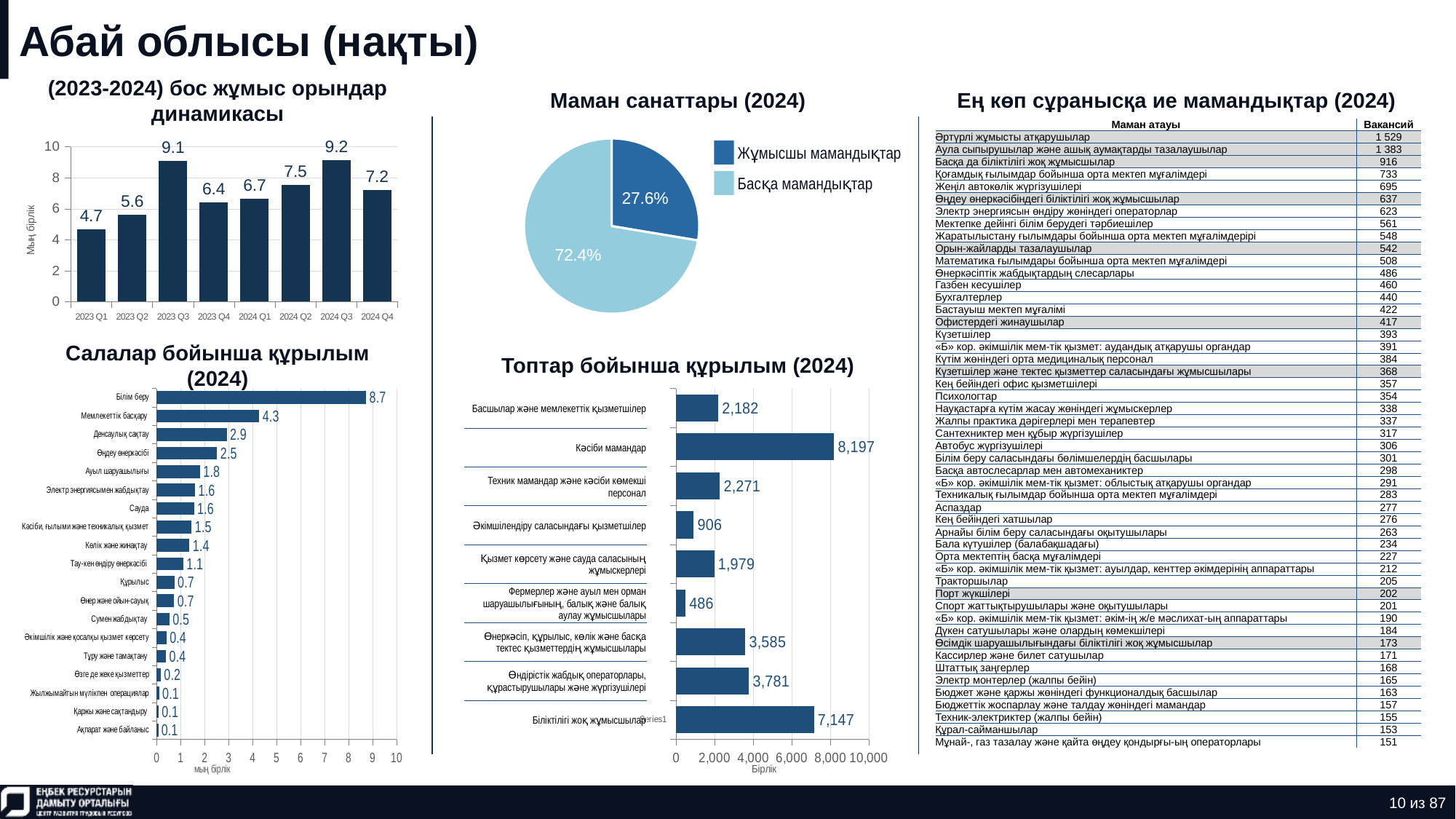
In the chart 'Топтар бойынша құрылым (2024)', which is larger: 'Өндірістік жабдық операторлары, құрастырушылары және жүргізушілері' or 'Өнеркәсіп, құрылыс, көлік және басқа тектес қызметтердің жұмысшылары'? Өндірістік жабдық операторлары, құрастырушылары және жүргізушілері In the chart '(2023-2024) бос жұмыс орындар динамикасы', what is the value for 2023 Q3? 9.1 In the chart 'Салалар бойынша құрылым (2024)', which category has the highest value? Білім беру In the chart 'Топтар бойынша құрылым (2024)', which category has the lowest value? Фермерлер және ауыл мен орман шаруашылығының, балық және балық аулау жұмысшылары In the chart 'Топтар бойынша құрылым (2024)', what is the value for 'Кәсіби мамандар'? 8,197 In the chart '(2023-2024) бос жұмыс орындар динамикасы', what is the difference between 2024 Q2 and 2024 Q1? 0.8 In the chart '(2023-2024) бос жұмыс орындар динамикасы', how many quarters are plotted? 8 In the chart 'Салалар бойынша құрылым (2024)', what is the value for 'Мемлекеттік басқару'? 4.3 In the chart '(2023-2024) бос жұмыс орындар динамикасы', which quarter has the highest value? 2024 Q3 What type of chart is 'Маман санаттары (2024)'? Pie chart In the chart '(2023-2024) бос жұмыс орындар динамикасы', which quarter has the lowest value? 2023 Q1 In the pie chart 'Маман санаттары (2024)', what share is 'Жұмысшы мамандықтар'? 27.6%